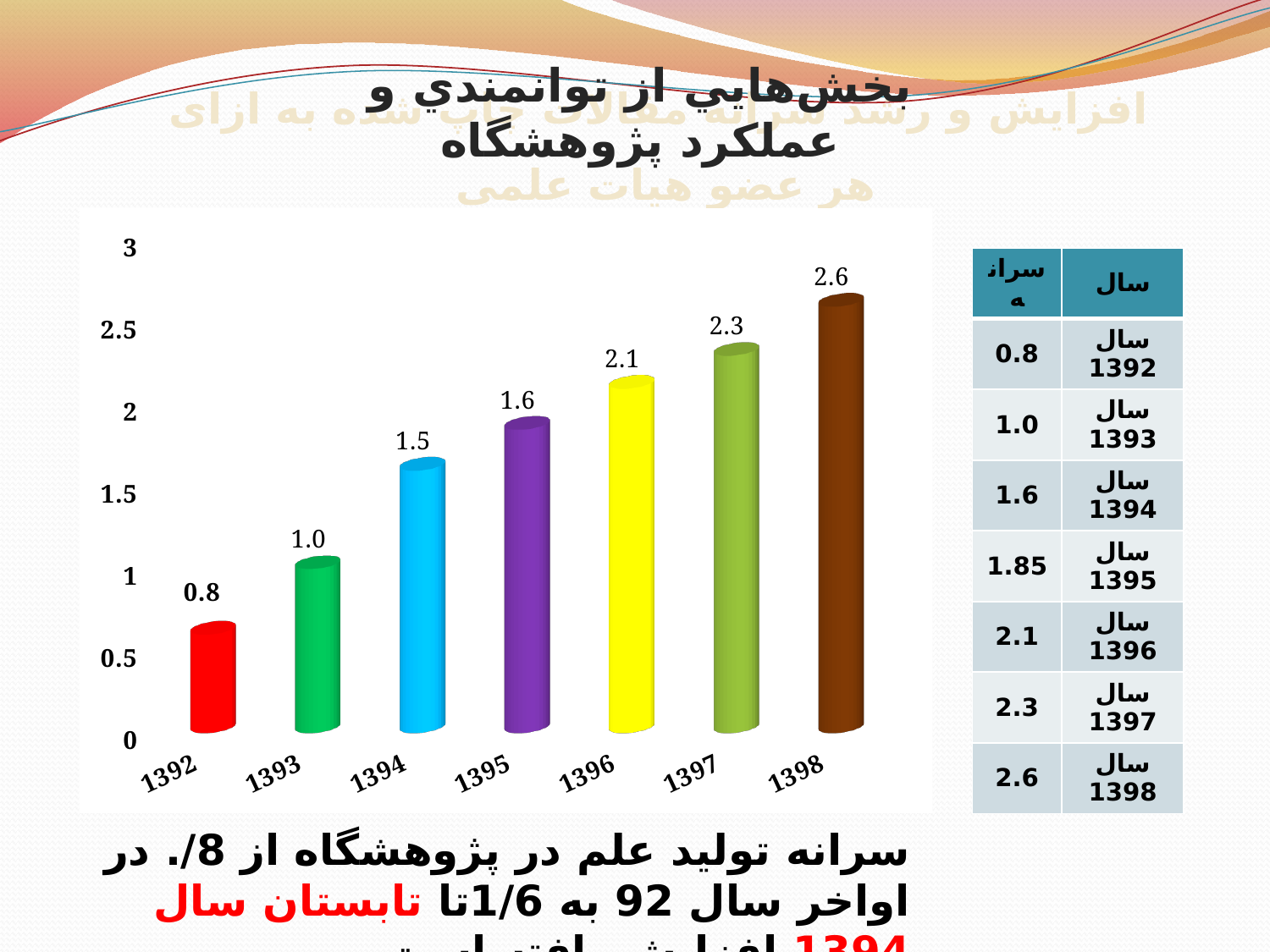
What is the difference between the values for 1398 and 1392? 1.8 What is the value for 1392? 0.8 Which year has the highest value? 1398 Which year has the lowest value? 1392 Do the values rise or fall from 1392 to 1398? rise How many years are shown on the x axis? 7 What kind of chart is this? bar chart What is the value for 1396? 2.1 What is the difference between the values for 1397 and 1396? 0.2 What is the value for 1394 according to the chart's data label? 1.5 Which is larger, the value for 1393 or the value for 1395? 1395 What is the value for 1398? 2.6